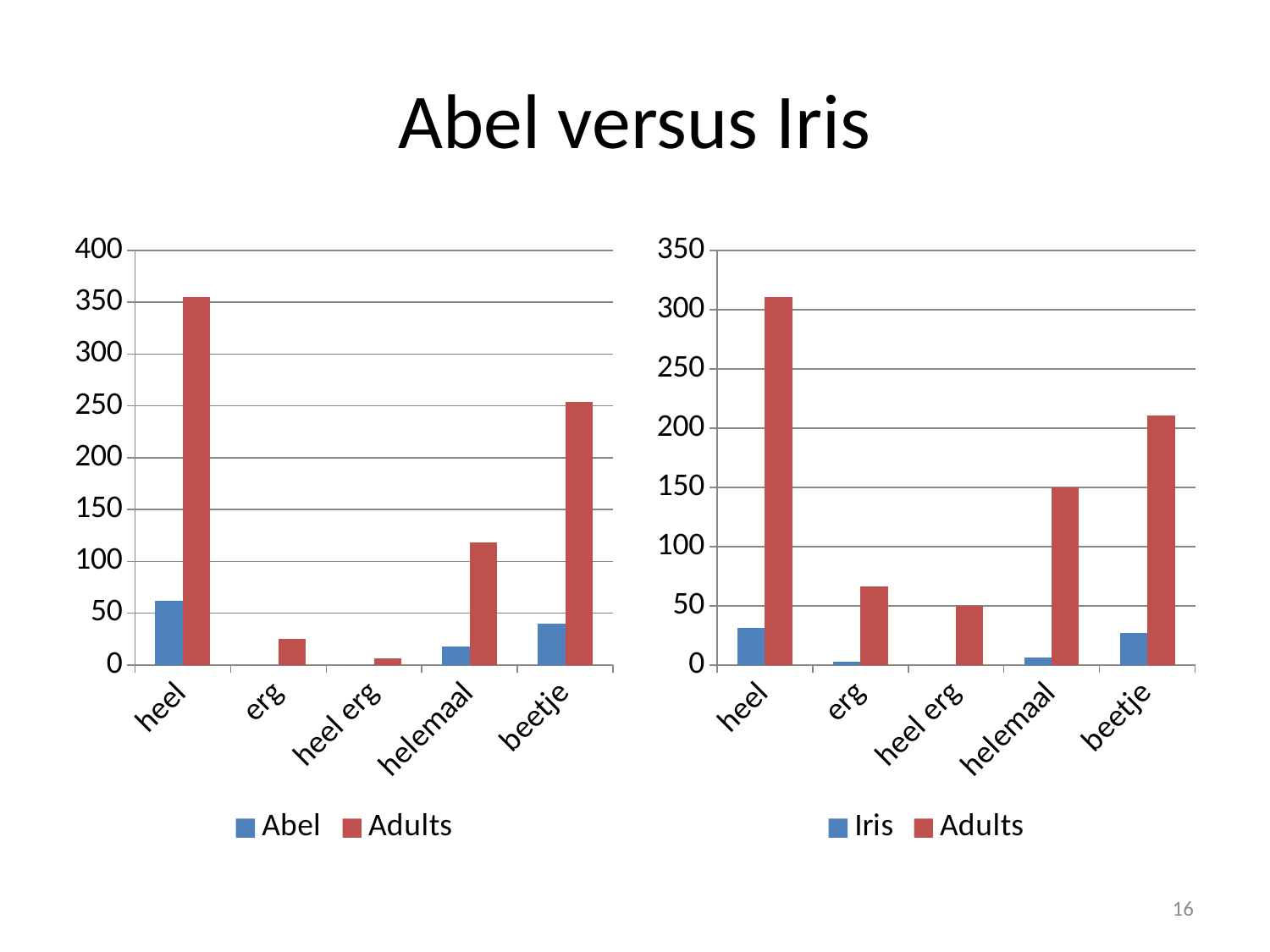
What type of chart is the left chart on the slide? bar chart In the right chart, is the Adults value for beetje greater or less than 150? greater In the left chart, is the Adults value for heel greater or less than 300? greater In the left chart, which category has the highest Adults value? heel How many categories are shown on the x axis of the right chart? 5 In the left chart, is the Adults value for helemaal greater or less than 100? greater In the left chart, which is larger: the Abel value for heel or the Abel value for beetje? heel How many series does the legend of the left chart list? 2 Which series are listed in the legend of the right chart? Iris and Adults In the right chart, which category has the highest Adults value? heel In the right chart, which category has the lowest Adults value? heel erg In the left chart, which category has the lowest Adults value? heel erg